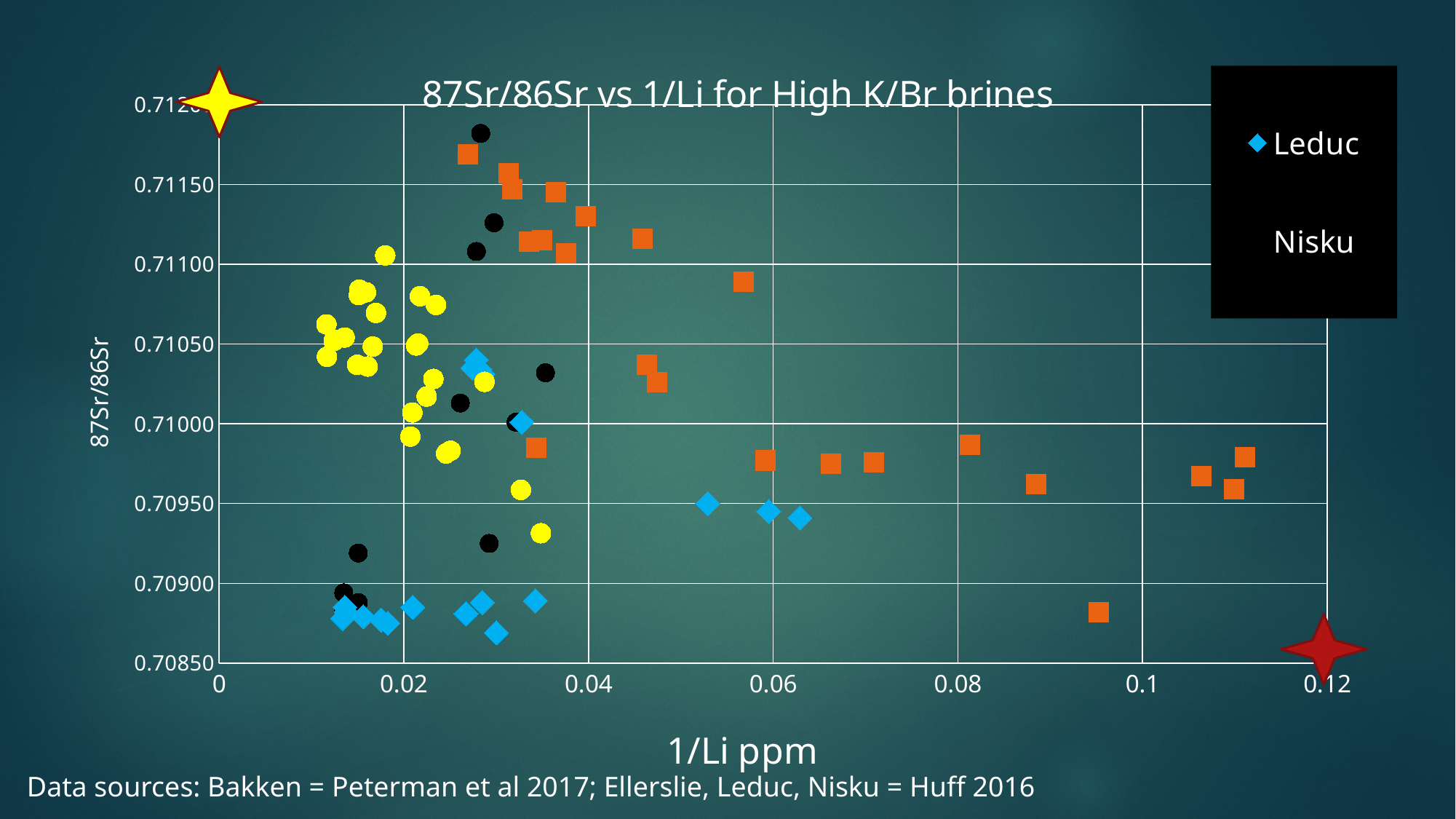
What is the label on the x axis of the chart? 1/Li ppm What is the title of the chart? 87Sr/86Sr vs 1/Li for High K/Br brines Is the highest 87Sr/86Sr value among the Leduc points greater or less than 0.71050? less Is the lowest 87Sr/86Sr value among the Leduc points greater or less than 0.70900? less Is the 87Sr/86Sr value of the Leduc point with the largest 1/Li value (near 0.063) greater or less than 0.71000? less What kind of chart is shown on the slide? scatter chart